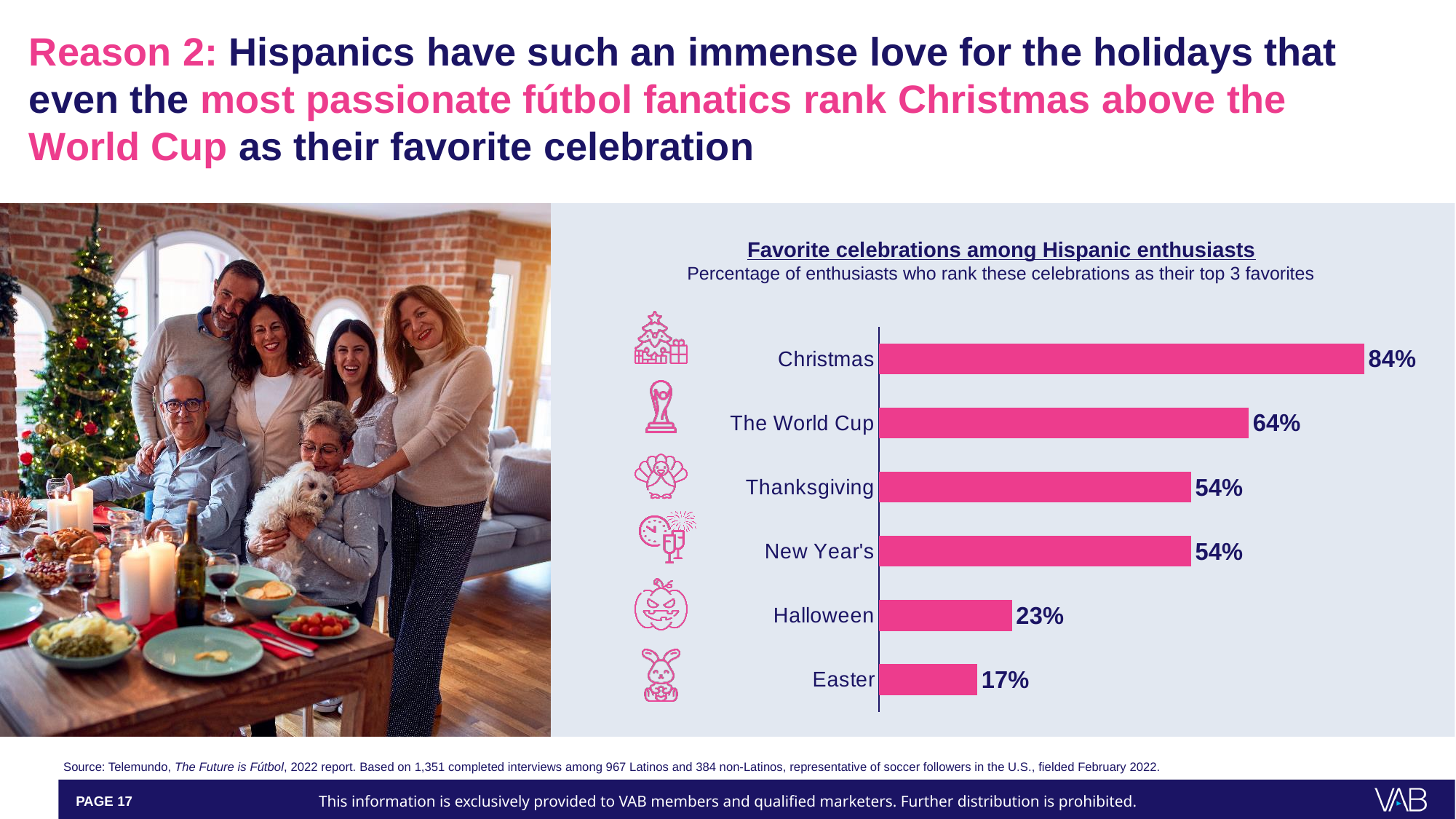
What is the difference in percentage points between Christmas and The World Cup? 20 What percentage of Hispanic enthusiasts rank Christmas among their top 3 favorite celebrations? 84% Which celebration has the lowest percentage in the chart? Easter What percentage is shown for Halloween? 23% What kind of chart is used to show the favorite celebrations? Bar chart Which celebration has the highest percentage in the chart? Christmas How many celebrations are shown in the chart? 6 Which has a higher percentage, Thanksgiving or Halloween? Thanksgiving What is the title of the chart? Favorite celebrations among Hispanic enthusiasts What is the difference in percentage points between Halloween and Easter? 6 Which two celebrations share the same percentage of 54%? Thanksgiving and New Year's What is the value shown for The World Cup? 64%